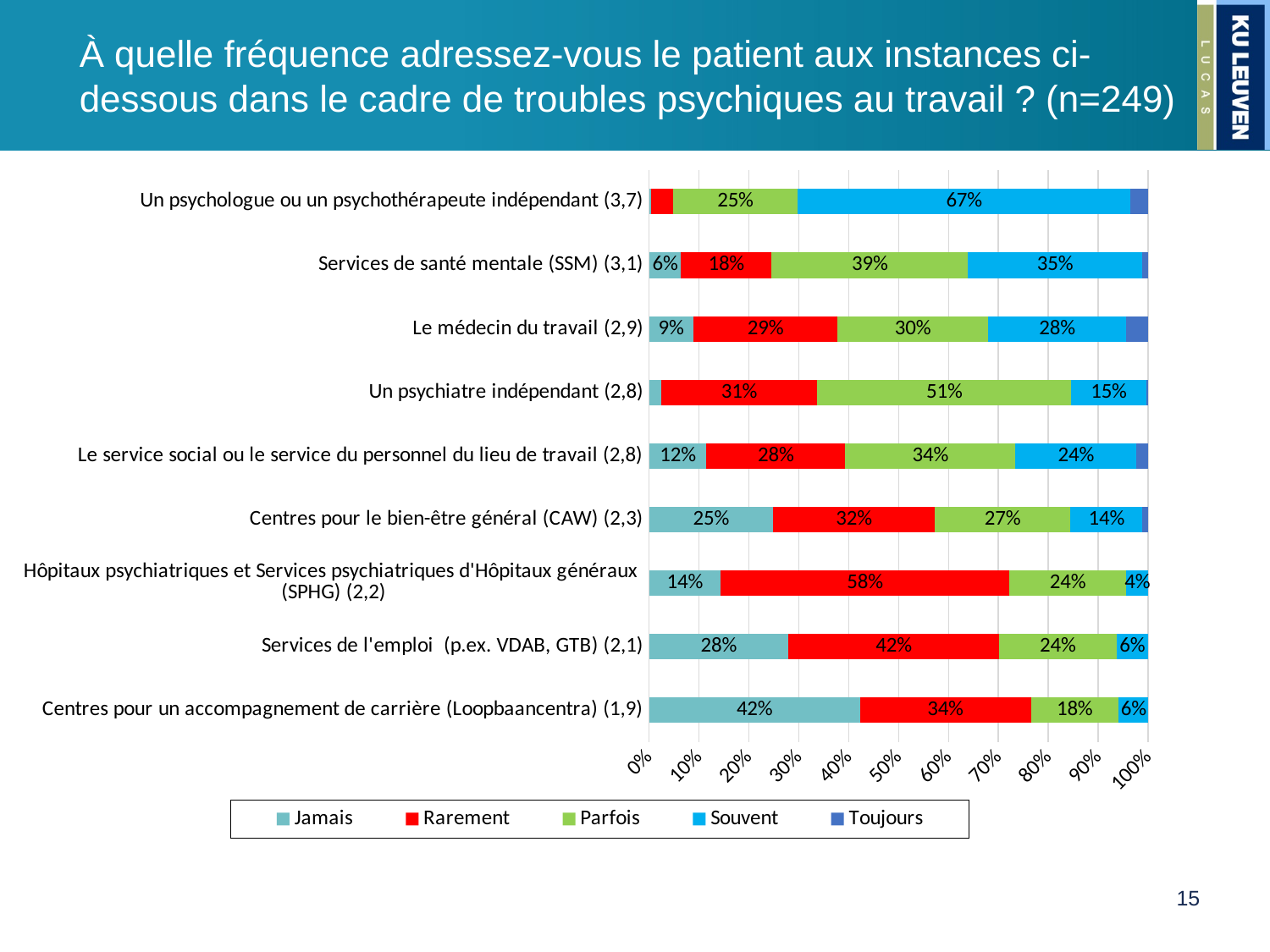
What is the 'Rarement' value for 'Hôpitaux psychiatriques et Services psychiatriques d'Hôpitaux généraux (SPHG) (2,2)'? 58% How many categories (instances) are plotted on the chart? 9 How many series does the legend list? 5 Which category has the highest 'Souvent' value? Un psychologue ou un psychothérapeute indépendant (3,7) Which category has the highest 'Jamais' value? Centres pour un accompagnement de carrière (Loopbaancentra) (1,9) What is the 'Jamais' value for 'Centres pour un accompagnement de carrière (Loopbaancentra) (1,9)'? 42% Which is larger: the 'Rarement' value for 'Services de l'emploi (p.ex. VDAB, GTB) (2,1)' or the 'Rarement' value for 'Centres pour le bien-être général (CAW) (2,3)'? Services de l'emploi (p.ex. VDAB, GTB) (2,1) What is the 'Souvent' value for 'Un psychologue ou un psychothérapeute indépendant (3,7)'? 67% What is the 'Parfois' value for 'Un psychiatre indépendant (2,8)'? 51% Which series is shown in red in the legend? Rarement What kind of chart is shown on the slide? Stacked bar chart What is the difference between the 'Parfois' value for 'Services de santé mentale (SSM) (3,1)' and the 'Parfois' value for 'Le médecin du travail (2,9)'? 9%